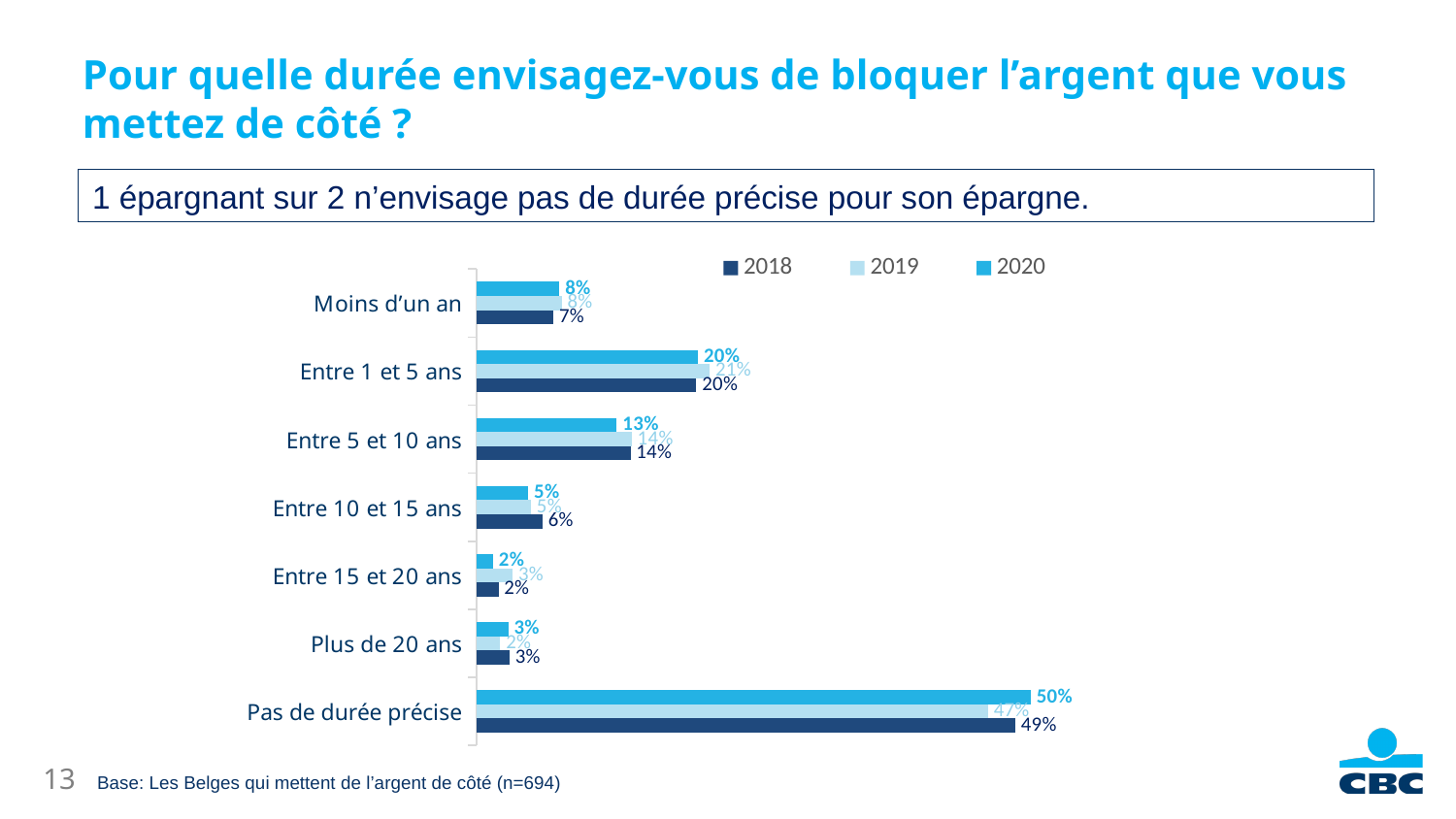
What is the 2018 value for "Moins d'un an"? 7% Which category has the lowest 2020 value? Entre 15 et 20 ans What is the 2020 value for "Pas de durée précise"? 50% How many categories are shown on the chart? 7 What is the 2018 value for "Entre 5 et 10 ans"? 14% What is the 2020 value for "Entre 1 et 5 ans"? 20% What is the difference between the 2020 and 2018 values for "Pas de durée précise"? 1% Which category has the highest 2020 value? Pas de durée précise Which series is shown in the darkest blue in the legend? 2018 What kind of chart is shown on the slide? bar chart How many series does the legend list? 3 Which is larger for "Entre 5 et 10 ans": the 2020 value or the 2018 value? 2018